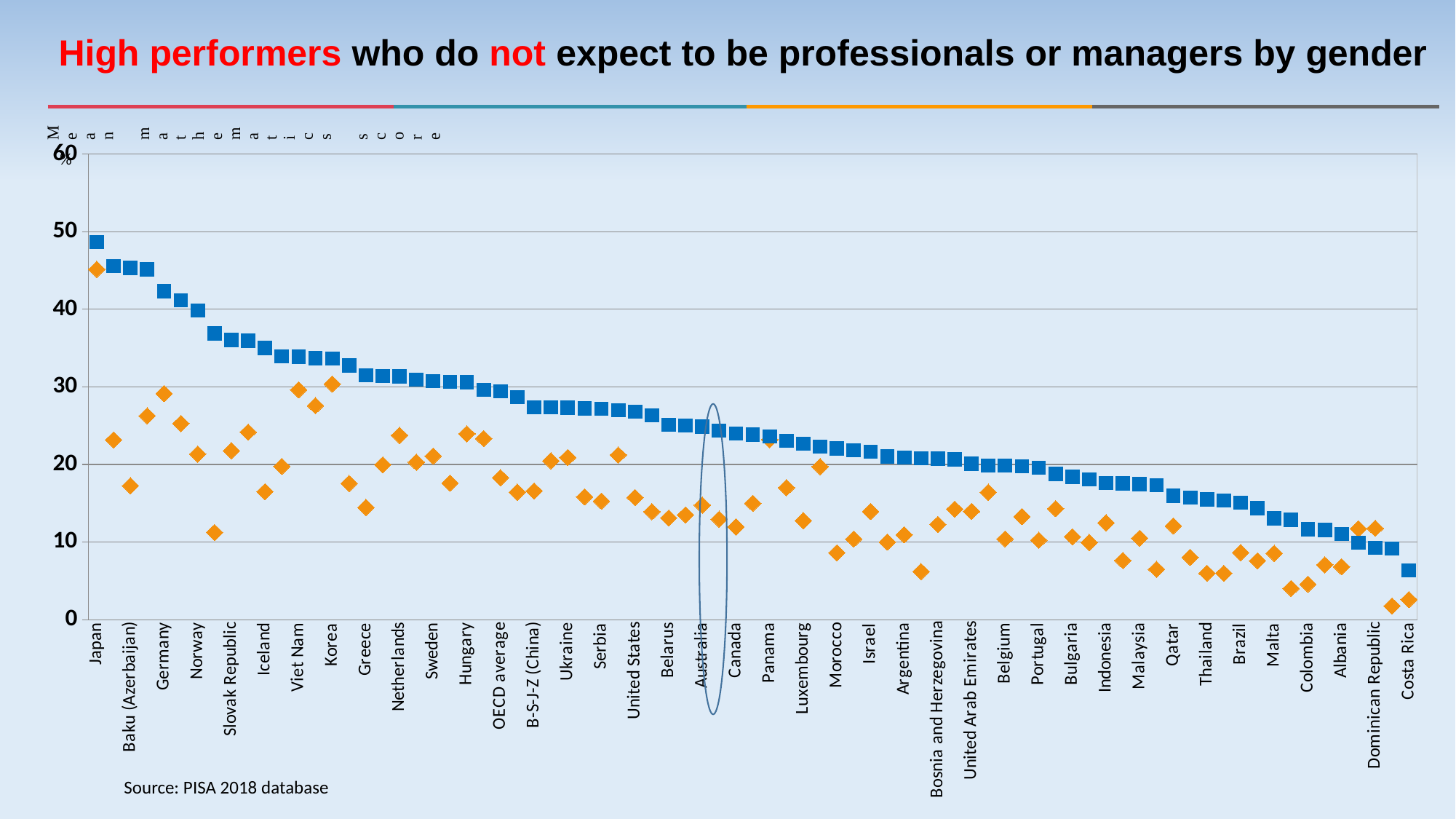
Which country has the highest value for the blue square series? Japan Is the orange diamond value for Morocco greater or less than 10? less What kind of chart is shown on the slide? scatter chart Do the blue square values rise or fall moving from left to right along the x axis? fall Is the blue square value for Costa Rica greater or less than 10? less How many data series are plotted on the chart? 2 Which country on the x axis is circled on the chart? Australia Is the blue square value for Japan greater or less than 40? greater For Germany, which series has the larger value, the blue squares or the orange diamonds? blue squares Which country has the highest value for the orange diamond series? Japan Which country has the lowest value for the blue square series? Costa Rica